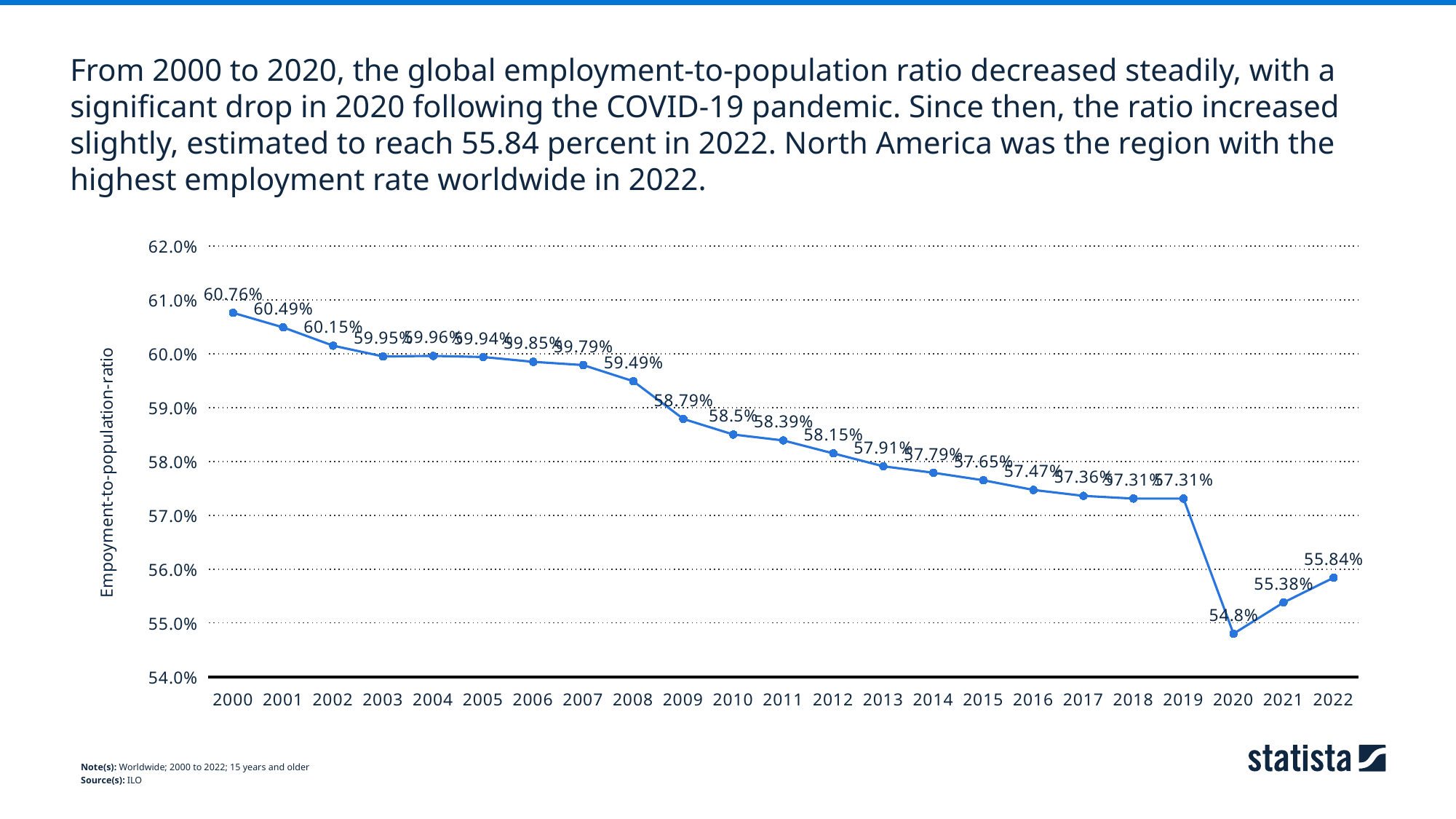
What was the employment-to-population ratio in 2012? 58.15% What was the employment-to-population ratio in 2020? 54.8% What was the global employment-to-population ratio in 2000? 60.76% What was the employment-to-population ratio in 2022? 55.84% Which year has the highest employment-to-population ratio? 2000 How many years are plotted on the chart? 23 By how many percentage points did the ratio increase from 2021 to 2022? 0.46 percentage points Which year had a higher employment-to-population ratio, 2008 or 2010? 2008 What is the overall trend of the employment-to-population ratio from 2000 to 2020? decreasing Which year has the lowest employment-to-population ratio? 2020 What type of chart is shown on the slide? line chart What was the employment-to-population ratio in 2009? 58.79%